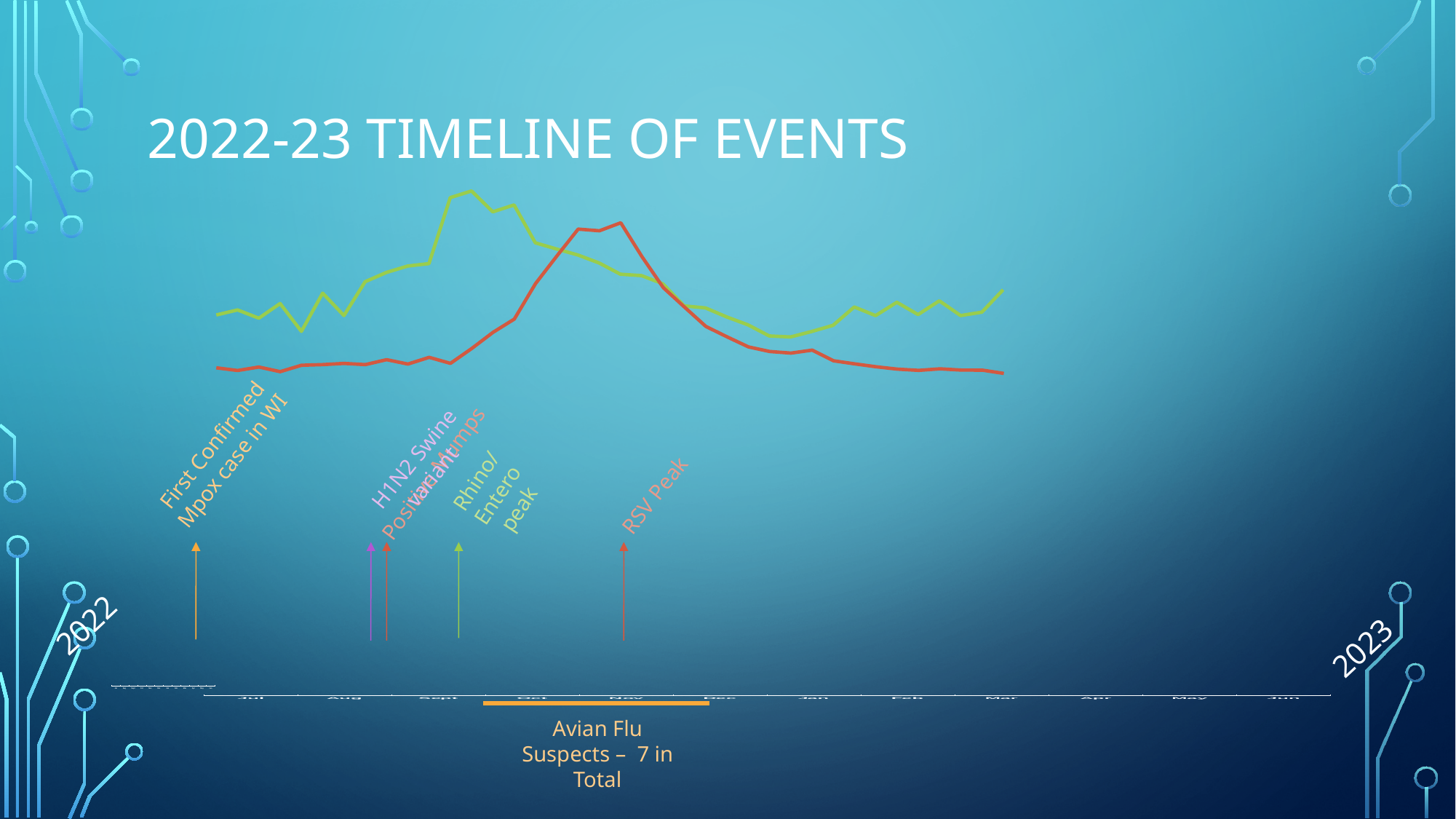
In which month does the green line reach its highest point? Sept Does the red line rise or fall between Jul and Nov? Rise Does the green line rise or fall between Sept and Jan? Fall Which line is higher in Nov, the green line or the red line? Red line Which line is higher in Sept, the green line or the red line? Green line What kind of chart is shown on the slide? Line chart What is the title of the slide containing the chart? 2022-23 Timeline of Events How many lines are plotted on the chart? 2 In which month does the red line reach its highest point? Nov Does the red line rise or fall between Nov and Mar? Fall What colours are the two lines plotted on the chart? Green and red Which line is higher in Feb, the green line or the red line? Green line